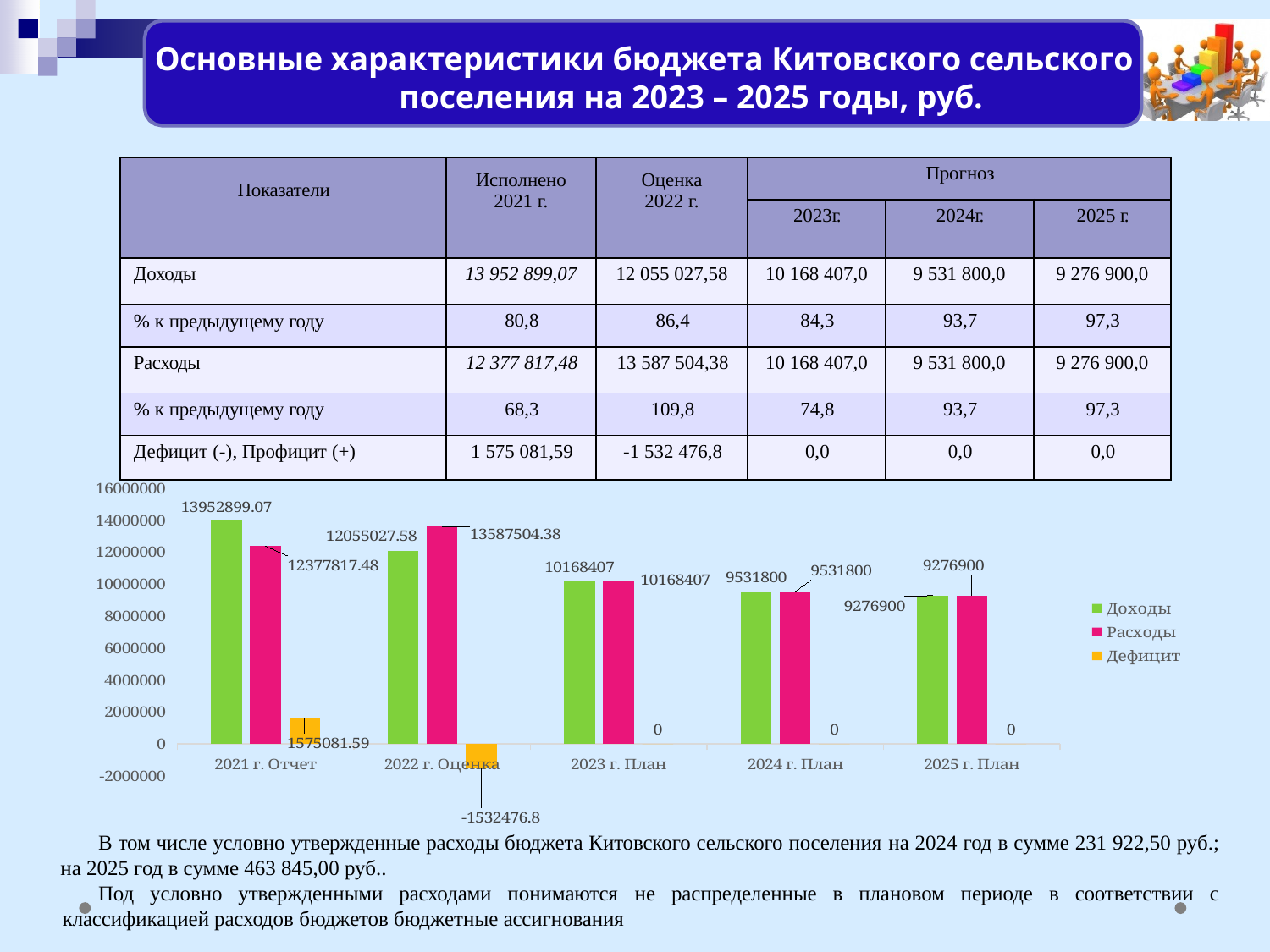
Which is larger in the chart for 2022 г. Оценка: Доходы or Расходы? Расходы In which year category is Расходы lowest in the chart? 2025 г. План What is the value of Доходы for 2025 г. План in the chart? 9276900 What type of chart is shown on the slide? bar chart How many year categories are shown on the x axis of the chart? 5 What is the value of Дефицит for 2022 г. Оценка in the chart? -1532476.8 How many series does the chart legend list? 3 What is the difference between Доходы and Расходы for 2021 г. Отчет in the chart? 1575081.59 In which year category is Доходы highest in the chart? 2021 г. Отчет Do the Доходы values rise or fall from 2021 г. Отчет to 2025 г. План in the chart? fall What is the value of Расходы for 2022 г. Оценка in the chart? 13587504.38 What is the value of Доходы for 2021 г. Отчет in the chart? 13952899.07